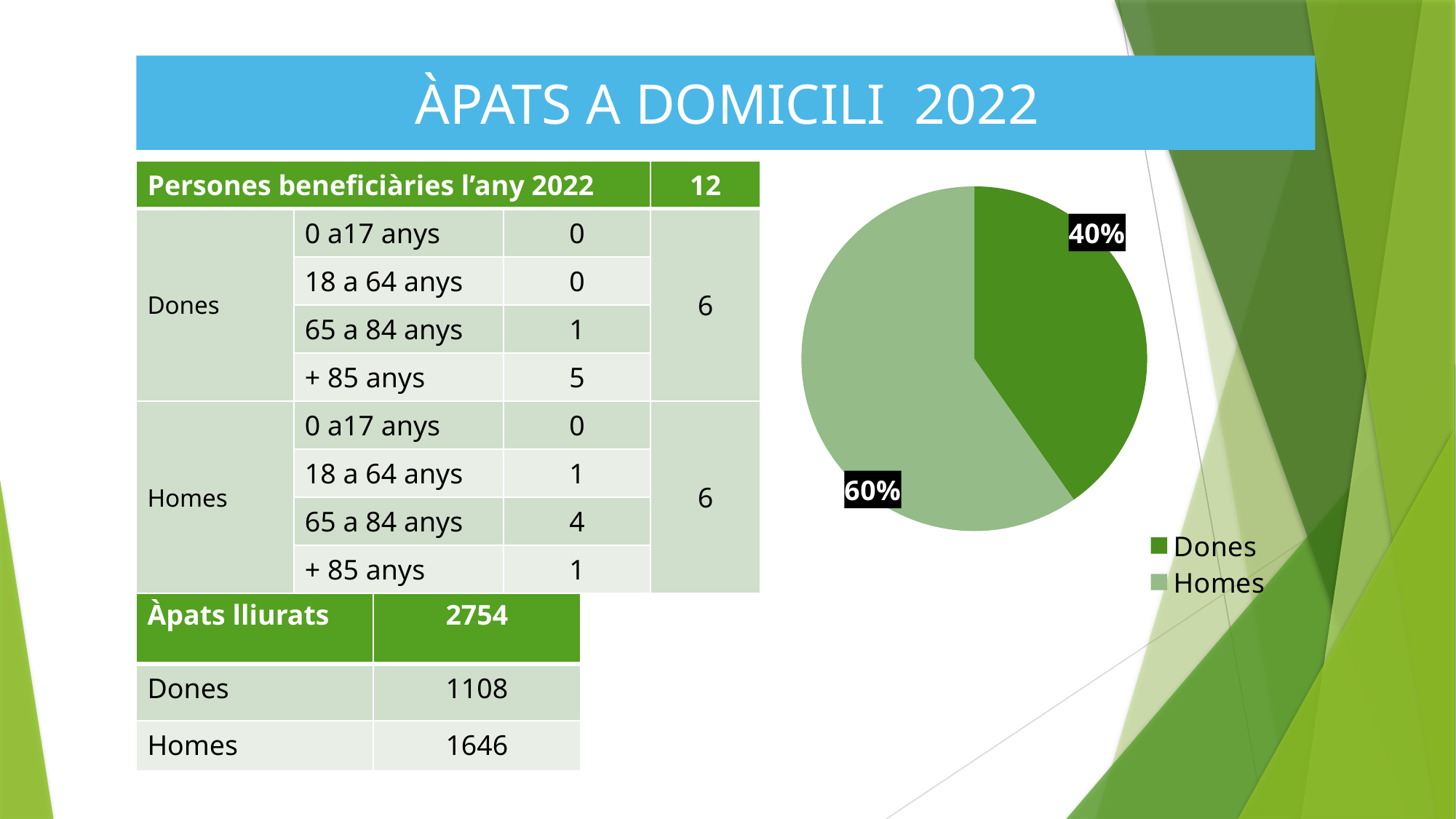
Which entries are listed in the pie chart legend? Dones, Homes Which slice of the pie chart is shown in the darker green? Dones What share of the pie chart does Homes represent? 60% Which slice of the pie chart is the smallest? Dones What share of the pie chart does Dones represent? 40% In the pie chart, which is larger, Dones or Homes? Homes What is the difference in percentage points between the Homes and Dones slices of the pie chart? 20% How many entries does the pie chart legend list? 2 How many slices does the pie chart have? 2 What kind of chart is shown on the slide? pie chart Which slice of the pie chart is the largest? Homes